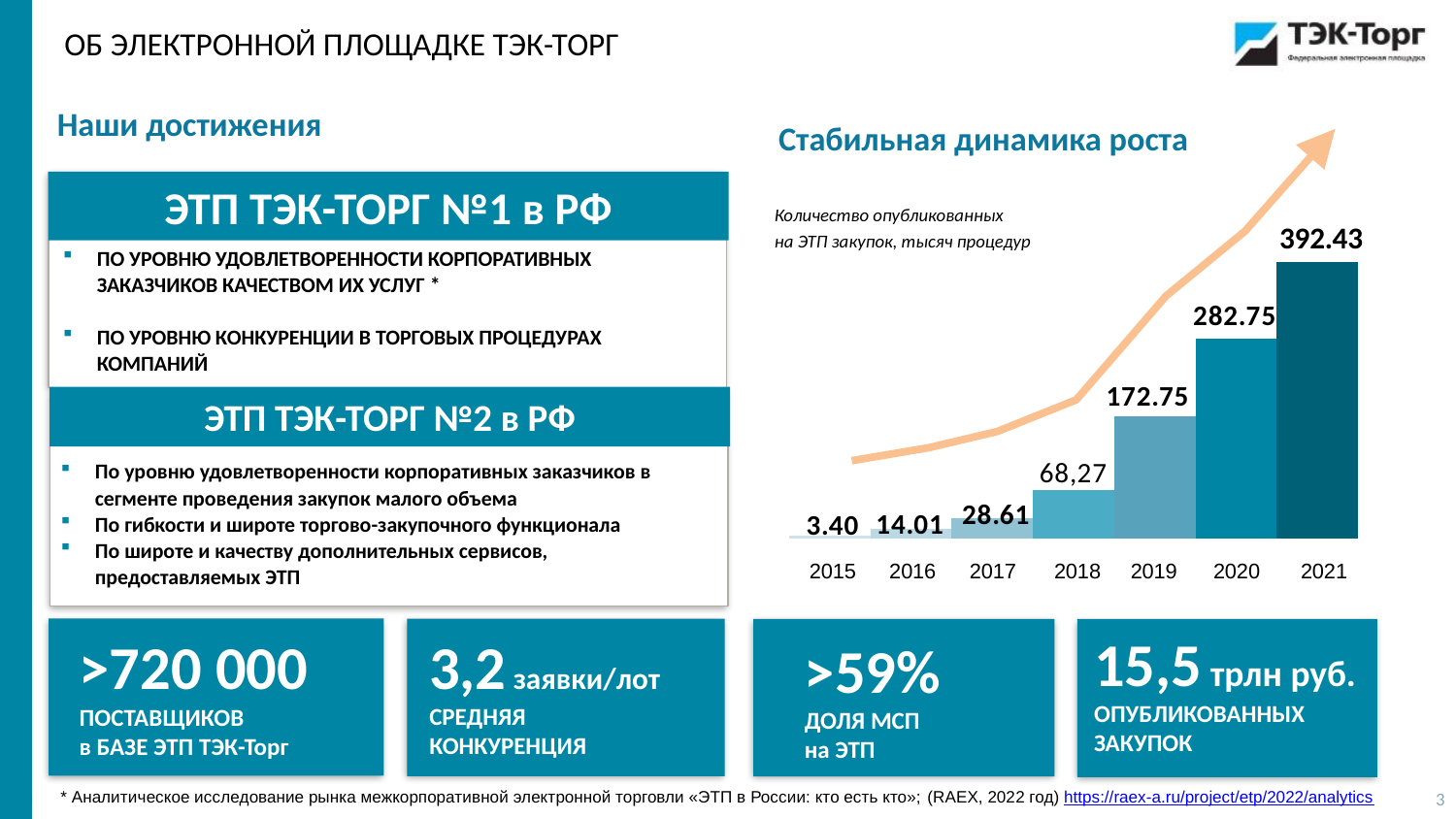
What is the difference between the values for 2021 and 2020? 109.68 Do the values rise or fall from 2015 to 2021? rise Which year has the highest value in the chart? 2021 What is the value for 2021 in the chart? 392.43 Which is larger, the value for 2019 or the value for 2020? 2020 What is the difference between the values for 2017 and 2016? 14.60 What is the value for 2018 in the chart? 68,27 What kind of chart is shown on the slide? bar chart What is the value for 2015 in the chart? 3.40 What is the value for 2019 in the chart? 172.75 Which year has the lowest value in the chart? 2015 How many years are shown on the x axis of the chart? 7